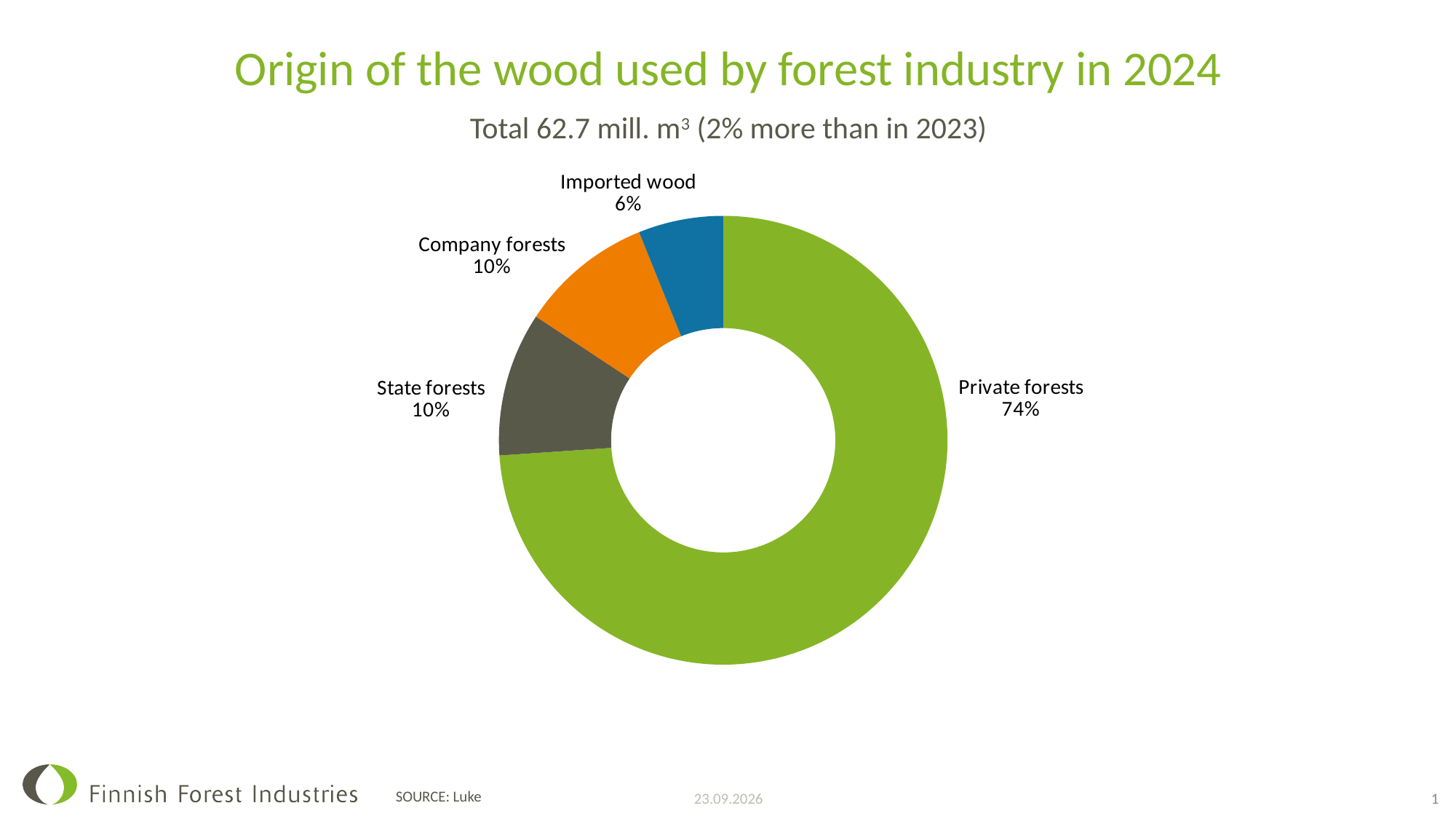
How many origin categories are shown in the chart? 4 What share of the wood came from state forests? 10% Which is larger, the share of company forests or the share of imported wood? Company forests What is the total volume of wood used by forest industry in 2024 according to the subtitle? 62.7 mill. m³ Which origin category has the largest share of the wood used? Private forests What share of the wood came from company forests? 10% What kind of chart is shown on the slide? Pie chart (doughnut) How many percentage points larger is the share of private forests than the share of state forests? 64 What is the title of the chart? Origin of the wood used by forest industry in 2024 What share of the wood came from imported wood? 6% What share of the wood used by forest industry in 2024 came from private forests? 74% Which origin category has the smallest share of the wood used? Imported wood